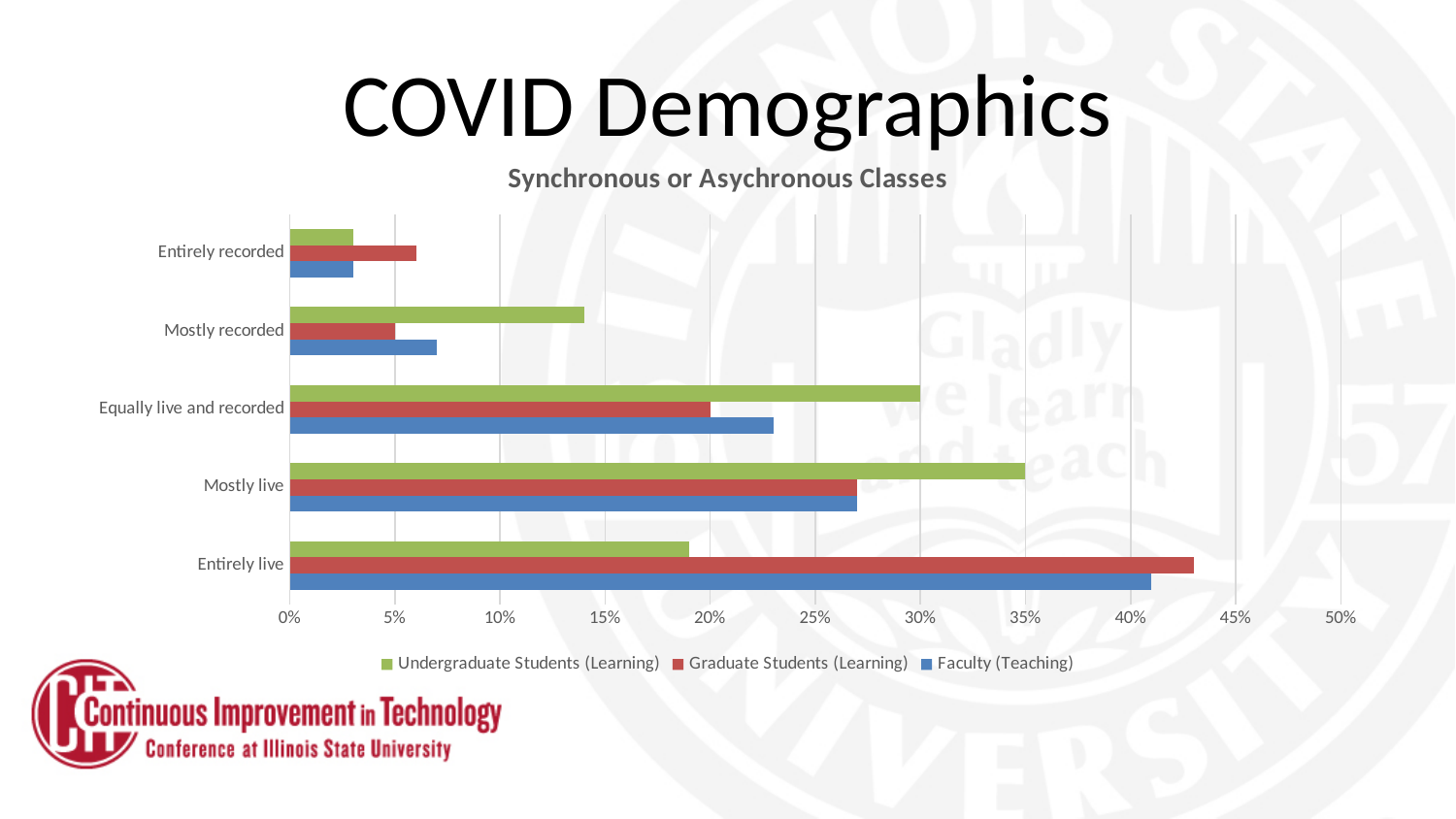
In the Mostly recorded category, which is larger: Undergraduate Students (Learning) or Faculty (Teaching)? Undergraduate Students (Learning) How many categories are shown on the vertical axis? 5 Which category has the highest value for Undergraduate Students (Learning)? Mostly live How many series does the legend list? 3 Which category has the highest value for Faculty (Teaching)? Entirely live What kind of chart is shown on the slide? bar chart Is the value for Graduate Students (Learning) in the Entirely live category greater or less than 40%? greater In the Entirely live category, which is larger: Graduate Students (Learning) or Undergraduate Students (Learning)? Graduate Students (Learning) What is the title of the chart? Synchronous or Asychronous Classes Which series is shown in green? Undergraduate Students (Learning)